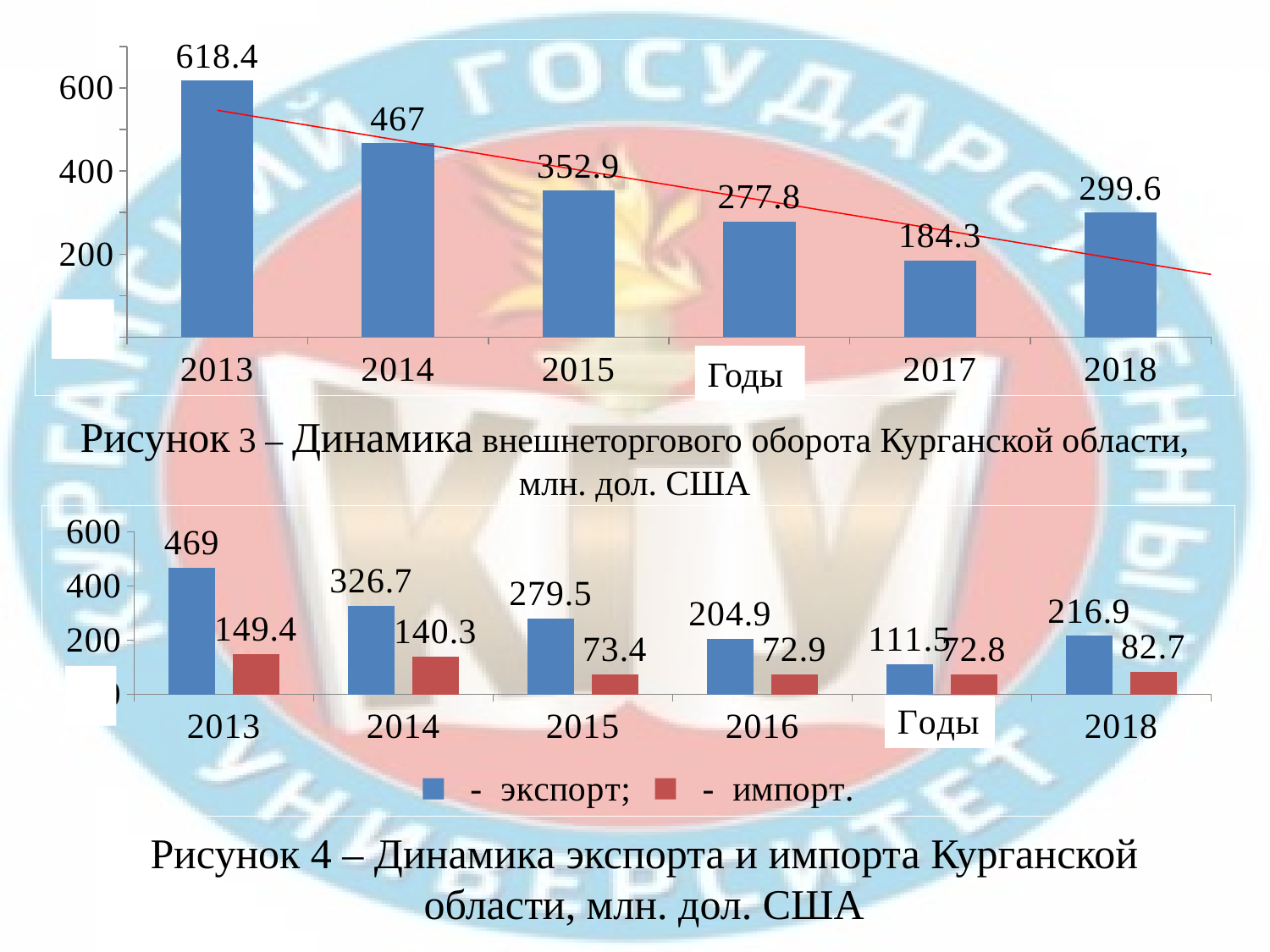
In the chart 'Рисунок 3 – Динамика внешнеторгового оборота Курганской области', which year has the lowest value? 2017 In the chart 'Рисунок 3 – Динамика внешнеторгового оборота Курганской области', which year has the highest value? 2013 In the chart 'Рисунок 4 – Динамика экспорта и импорта Курганской области', what is the import value for 2018? 82.7 In the chart 'Рисунок 4 – Динамика экспорта и импорта Курганской области', what is the difference between export and import in 2013? 319.6 In the chart 'Рисунок 3 – Динамика внешнеторгового оборота Курганской области', what is the value for 2018? 299.6 In the chart 'Рисунок 3 – Динамика внешнеторгового оборота Курганской области', what is the value for 2013? 618.4 What type of chart is 'Рисунок 4 – Динамика экспорта и импорта Курганской области'? bar chart In the chart 'Рисунок 4 – Динамика экспорта и импорта Курганской области', which is larger in 2015: export or import? export In the chart 'Рисунок 3 – Динамика внешнеторгового оборота Курганской области', how many bars are plotted? 6 In the chart 'Рисунок 3 – Динамика внешнеторгового оборота Курганской области', what is the difference between the values for 2013 and 2014? 151.4 In the chart 'Рисунок 4 – Динамика экспорта и импорта Курганской области', what is the export value for 2014? 326.7 In the chart 'Рисунок 4 – Динамика экспорта и импорта Курганской области', how many series does the legend list? 2